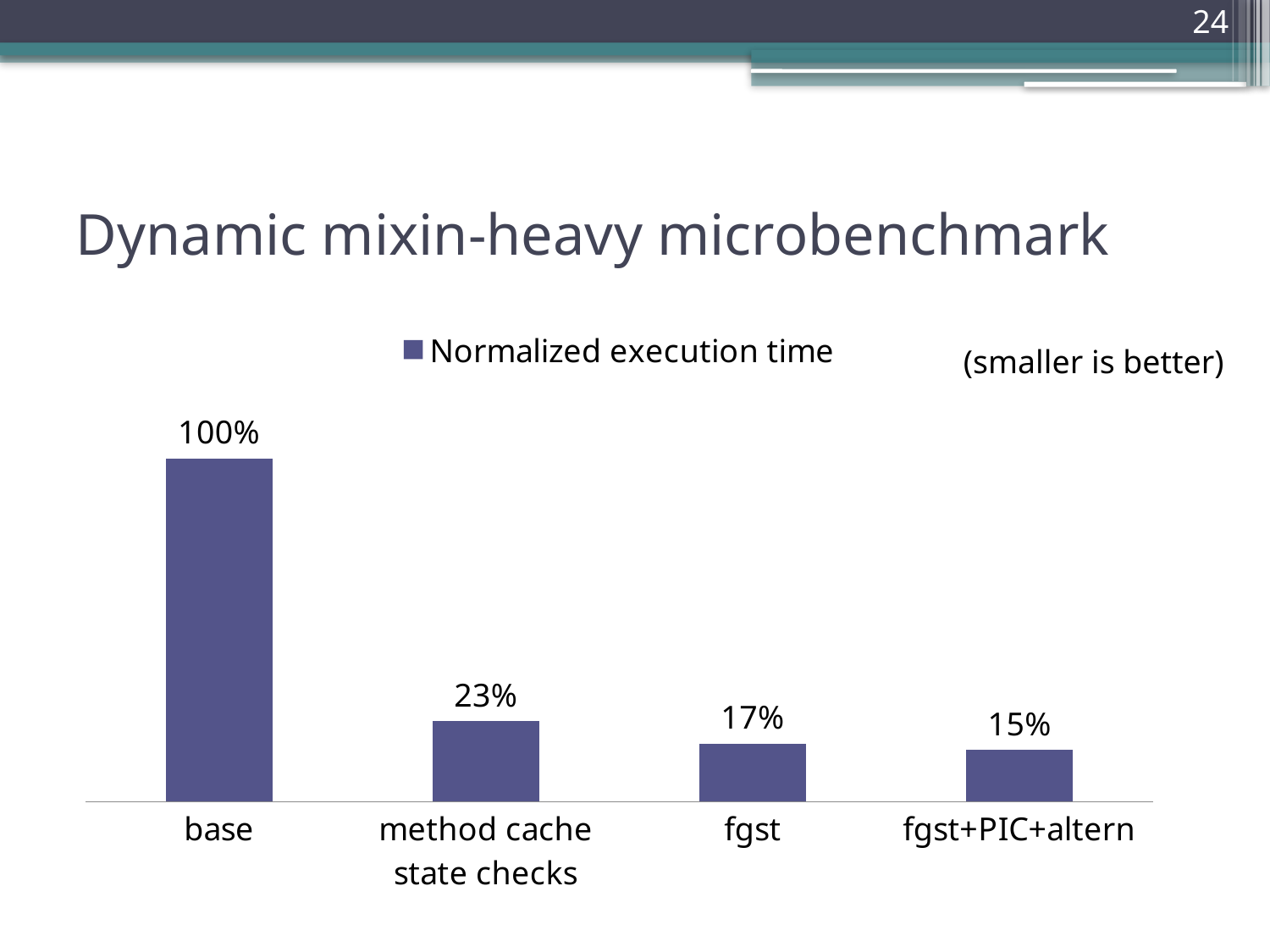
What kind of chart is shown on the slide? bar chart Which category has the lowest normalized execution time? fgst+PIC+altern How many categories are shown in the chart? 4 Which has a larger normalized execution time, method cache state checks or fgst? method cache state checks Which category has the highest normalized execution time? base What series name does the legend show? Normalized execution time What is the normalized execution time for fgst+PIC+altern? 15% What is the normalized execution time for base? 100% What is the difference in normalized execution time between method cache state checks and fgst+PIC+altern? 8% What is the normalized execution time for fgst? 17% What is the normalized execution time for method cache state checks? 23% What is the difference in normalized execution time between base and fgst? 83%